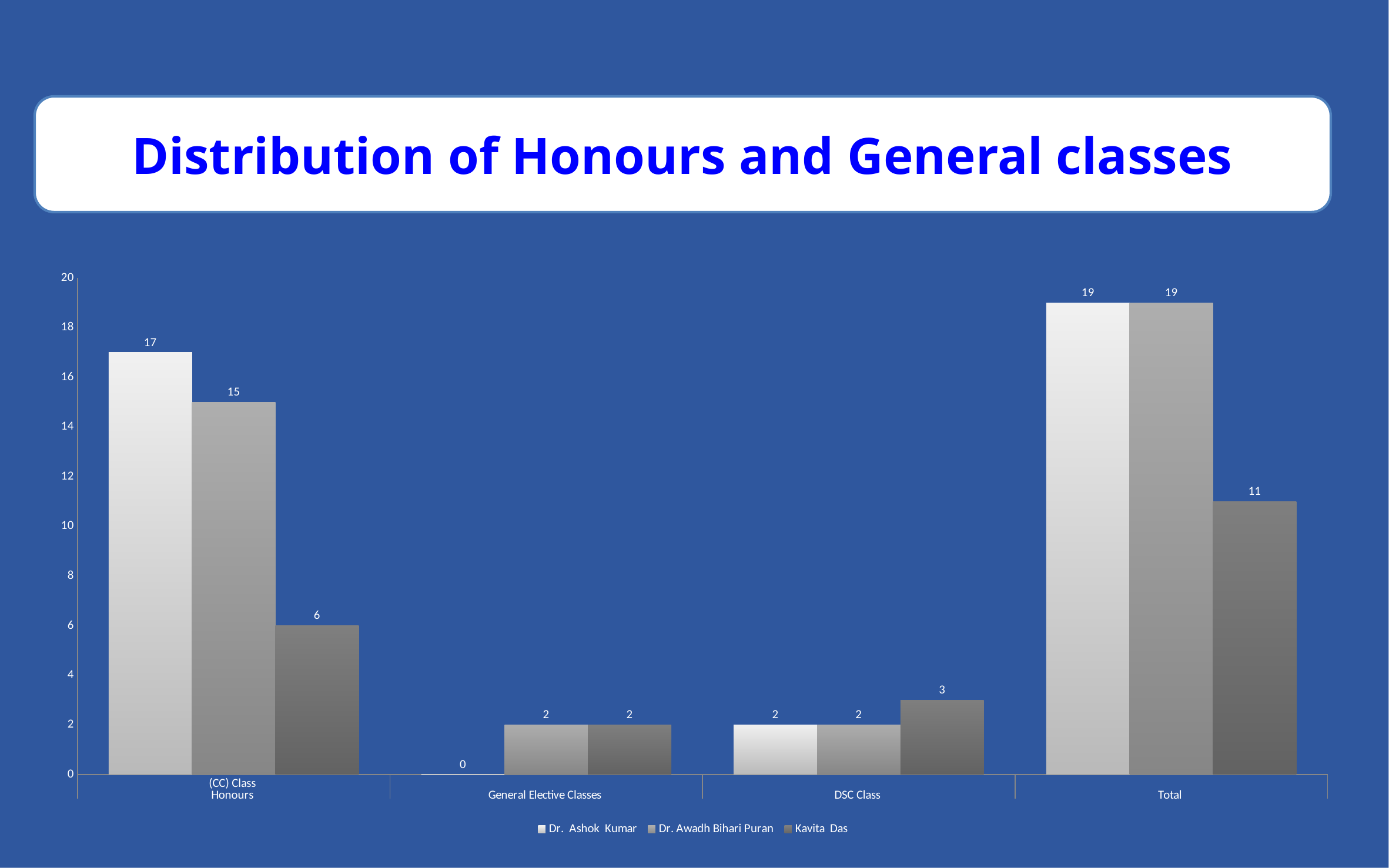
Which category has the lowest value for Dr. Ashok Kumar? General Elective Classes Which is larger in the (CC) Class Honours category: Dr. Ashok Kumar or Dr. Awadh Bihari Puran? Dr. Ashok Kumar Which category has the highest value for Kavita Das? Total What is the difference between Dr. Ashok Kumar and Kavita Das in the (CC) Class Honours category? 11 What is the value for Dr. Ashok Kumar in the General Elective Classes category? 0 What is the value for Kavita Das in the Total category? 11 What is the title of the slide? Distribution of Honours and General classes What is the value for Dr. Ashok Kumar in the (CC) Class Honours category? 17 What kind of chart is shown on the slide? Bar chart How many categories are shown on the x axis? 4 What is the value for Kavita Das in the DSC Class category? 3 How many series does the legend list? 3